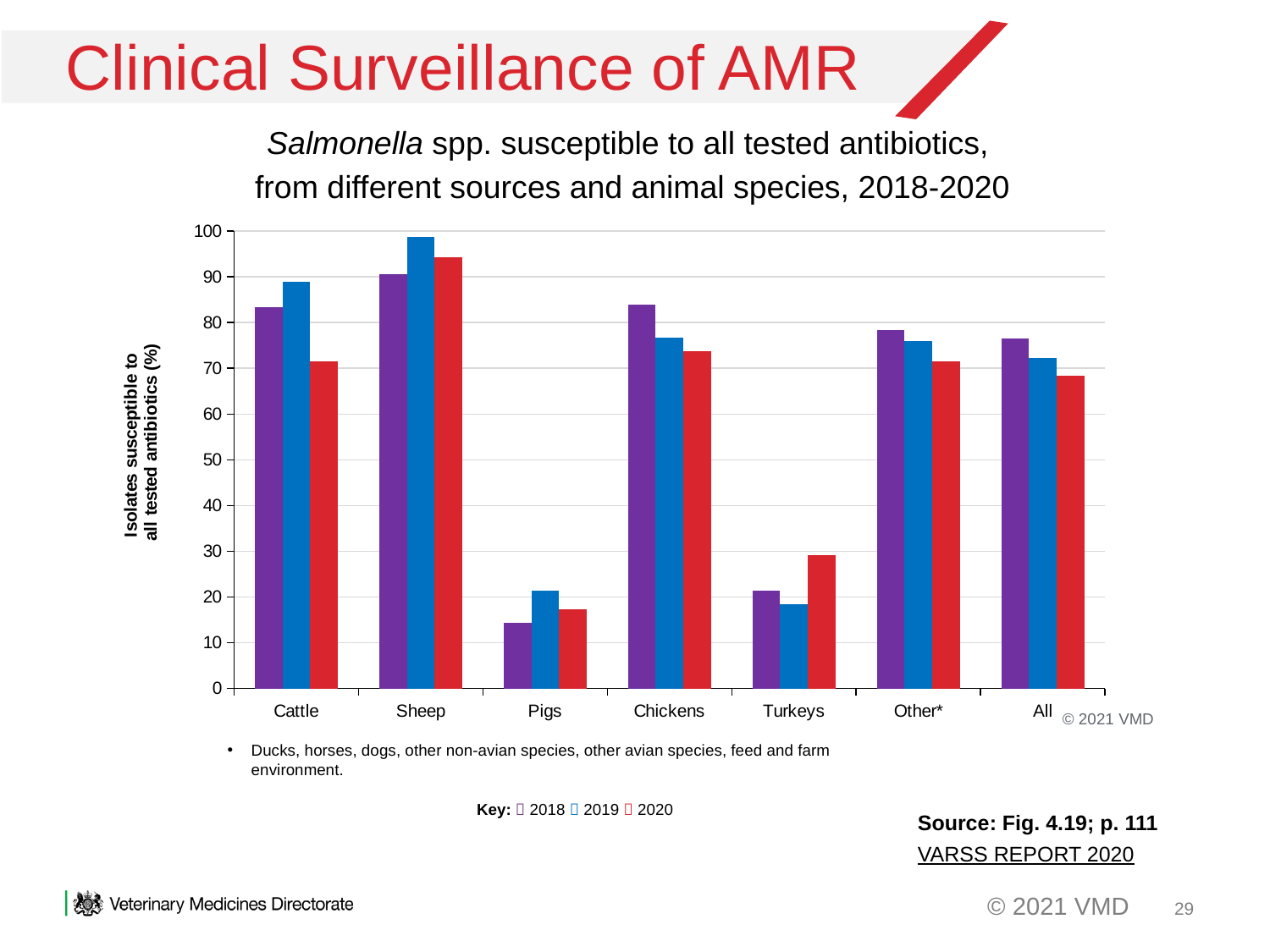
Is the 2019 value for Sheep greater or less than 90? greater How many years (series) does the key list? 3 Which category has the highest percentage of isolates susceptible to all tested antibiotics in 2019? Sheep Which category has the highest percentage of susceptible isolates in 2020? Sheep Which is larger in 2020: the value for Turkeys or the value for Pigs? Turkeys What kind of chart is shown on the slide? bar chart Is the 2020 value for Cattle greater or less than 80? less For the 'All' category, do the values rise or fall from 2018 to 2020? fall How many animal source categories are shown along the x axis? 7 Is the 2018 value for Pigs greater or less than 20? less What colour represents 2020 in the key? red Which category has the lowest percentage of susceptible isolates in 2018? Pigs